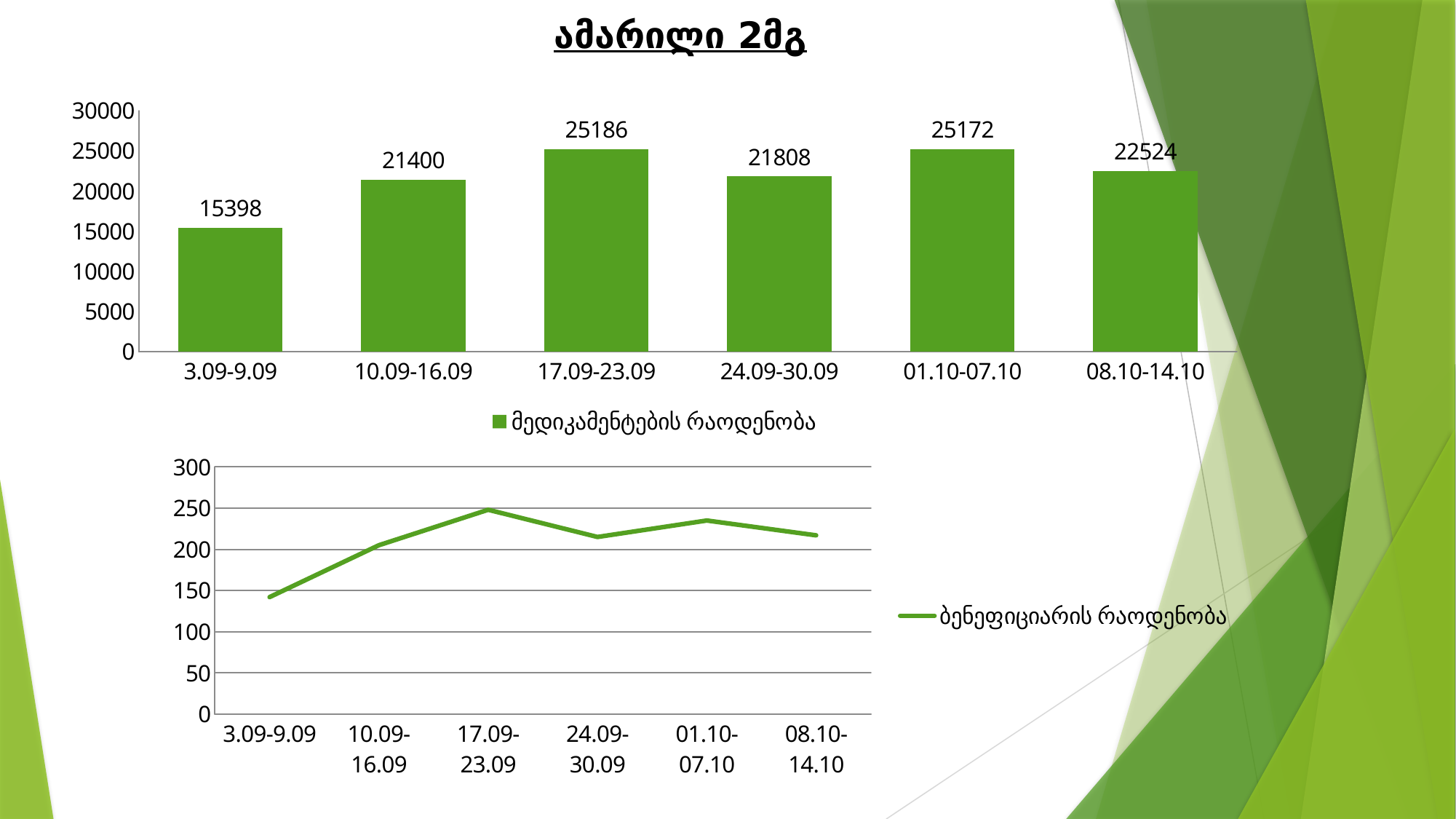
In the top bar chart, what is the value for 3.09-9.09? 15398 In the top bar chart, which period has the lowest value? 3.09-9.09 In the top bar chart, what is the value for 17.09-23.09? 25186 In the top bar chart, which is larger: the value for 01.10-07.10 or the value for 08.10-14.10? 01.10-07.10 In the top bar chart, what is the value for 08.10-14.10? 22524 What is the legend entry of the bottom line chart? ბენეფიციარის რაოდენობა In the bottom line chart, is the value for 01.10-07.10 greater or less than 200? greater What kind of chart is the top chart on the slide? bar chart What kind of chart is the bottom chart on the slide? line chart In the bottom line chart, is the value for 3.09-9.09 greater or less than 150? less In the top bar chart, what is the difference between the values for 10.09-16.09 and 24.09-30.09? 408 How many bars are in the top bar chart? 6